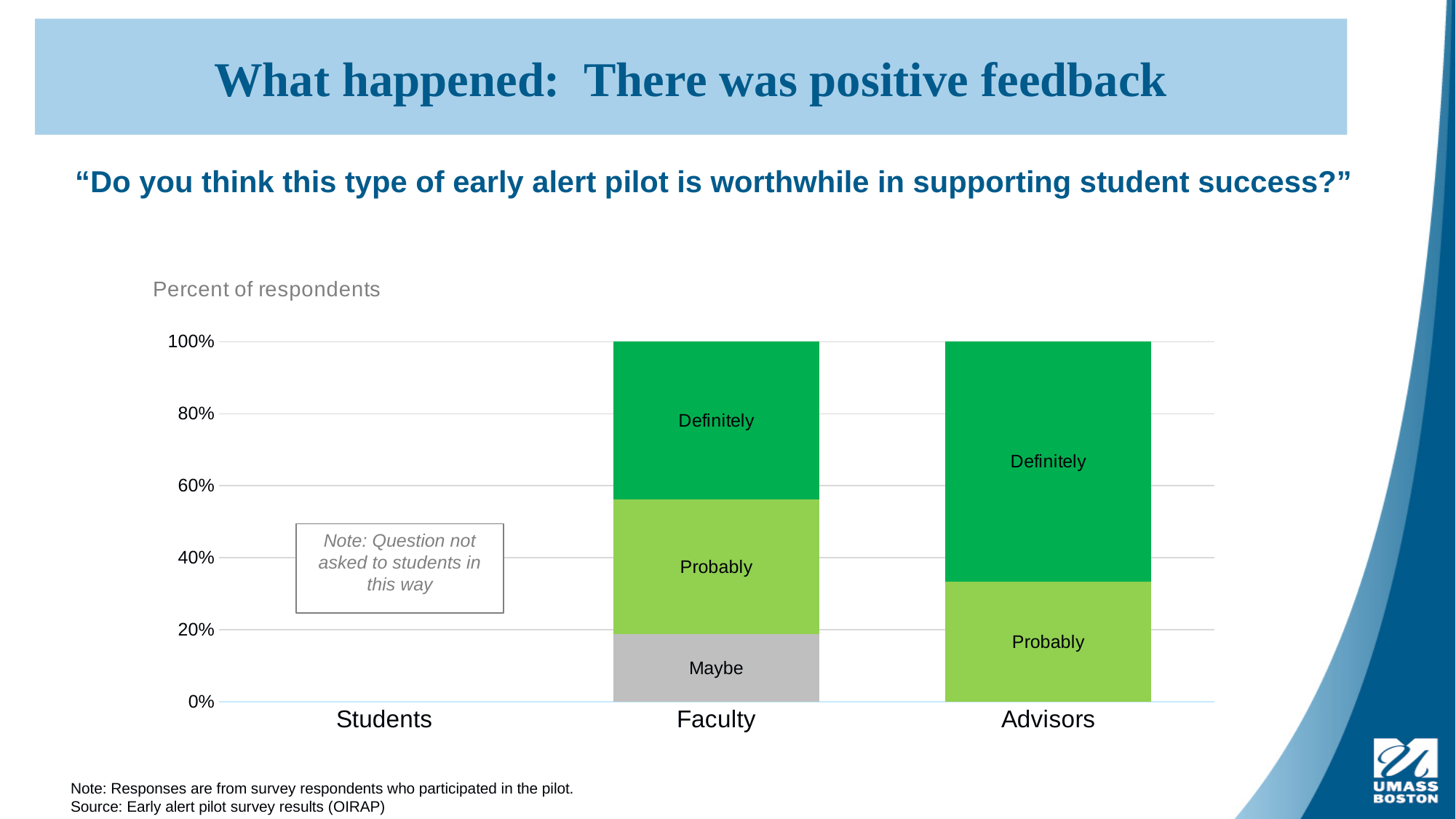
What is the total height of the stacked bar for Advisors? 100% What kind of chart is shown on the slide? Stacked bar chart What does the label above the chart say the values represent? Percent of respondents Is the 'Definitely' share for Faculty greater or less than 60%? less How many categories are shown on the x axis of the chart? 3 Is the 'Probably' share for Advisors greater or less than 40%? less Which category on the chart has no bar plotted? Students Which group has the larger 'Probably' share, Faculty or Advisors? Faculty Is the 'Definitely' share for Advisors greater or less than 60%? greater Which group has the larger 'Definitely' share, Faculty or Advisors? Advisors What is the total height of the stacked bar for Faculty? 100%